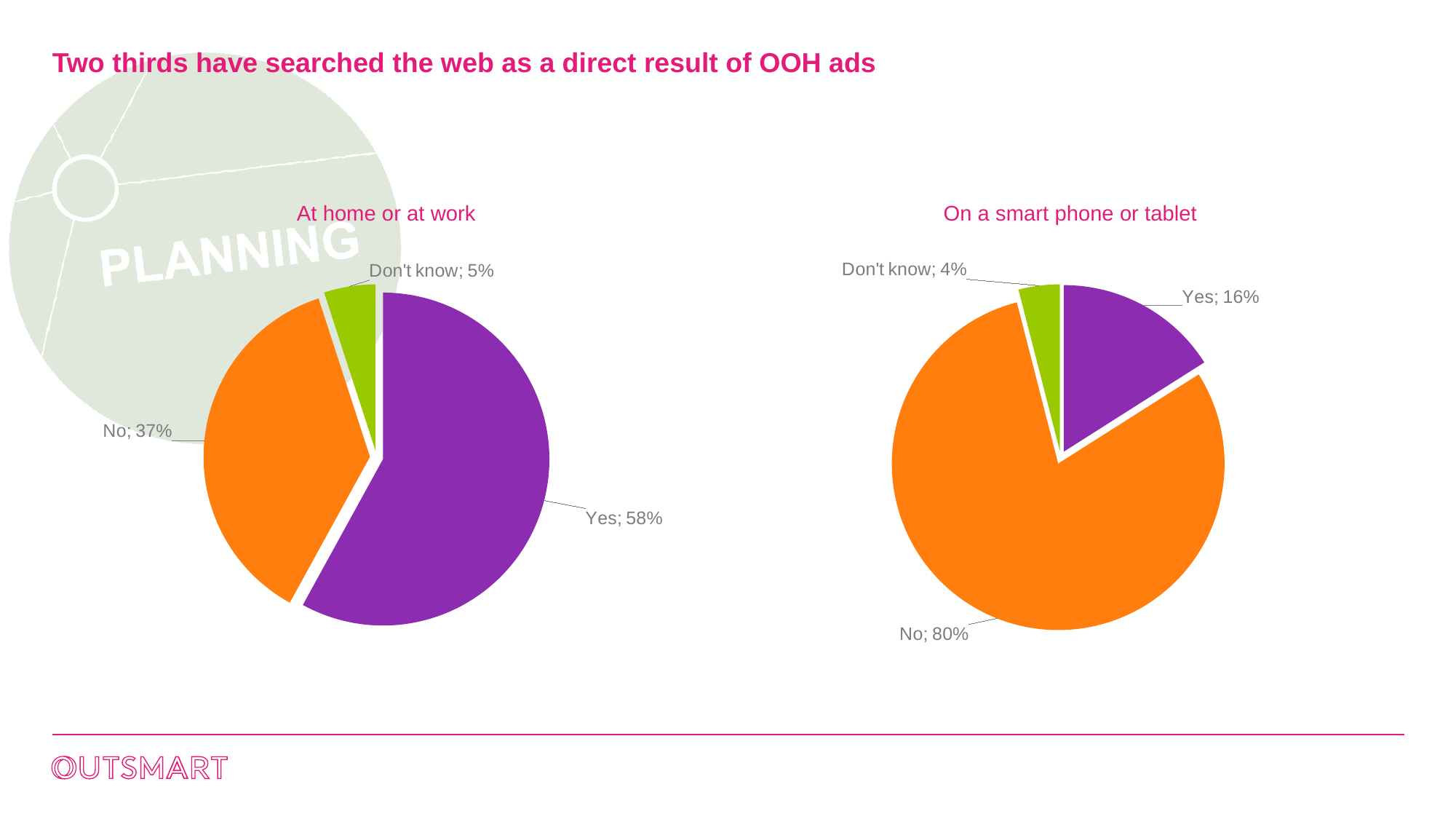
In the 'On a smart phone or tablet' chart, which response has the smallest slice? Don't know In the 'On a smart phone or tablet' chart, what share of respondents answered Don't know? 4% How many slices does the 'On a smart phone or tablet' chart have? 3 In the 'On a smart phone or tablet' chart, what is the difference between the No and Yes shares? 64% What type of chart is used for 'At home or at work'? Pie chart In the 'At home or at work' chart, which response has the largest slice? Yes Which chart has the larger Yes share, 'At home or at work' or 'On a smart phone or tablet'? At home or at work In the 'At home or at work' chart, what share of respondents answered No? 37% In the 'At home or at work' chart, what share of respondents answered Yes? 58% What colour is the No slice in the 'On a smart phone or tablet' chart? Orange In the 'On a smart phone or tablet' chart, what share of respondents answered No? 80% In the 'At home or at work' chart, what is the difference between the Yes and No shares? 21%